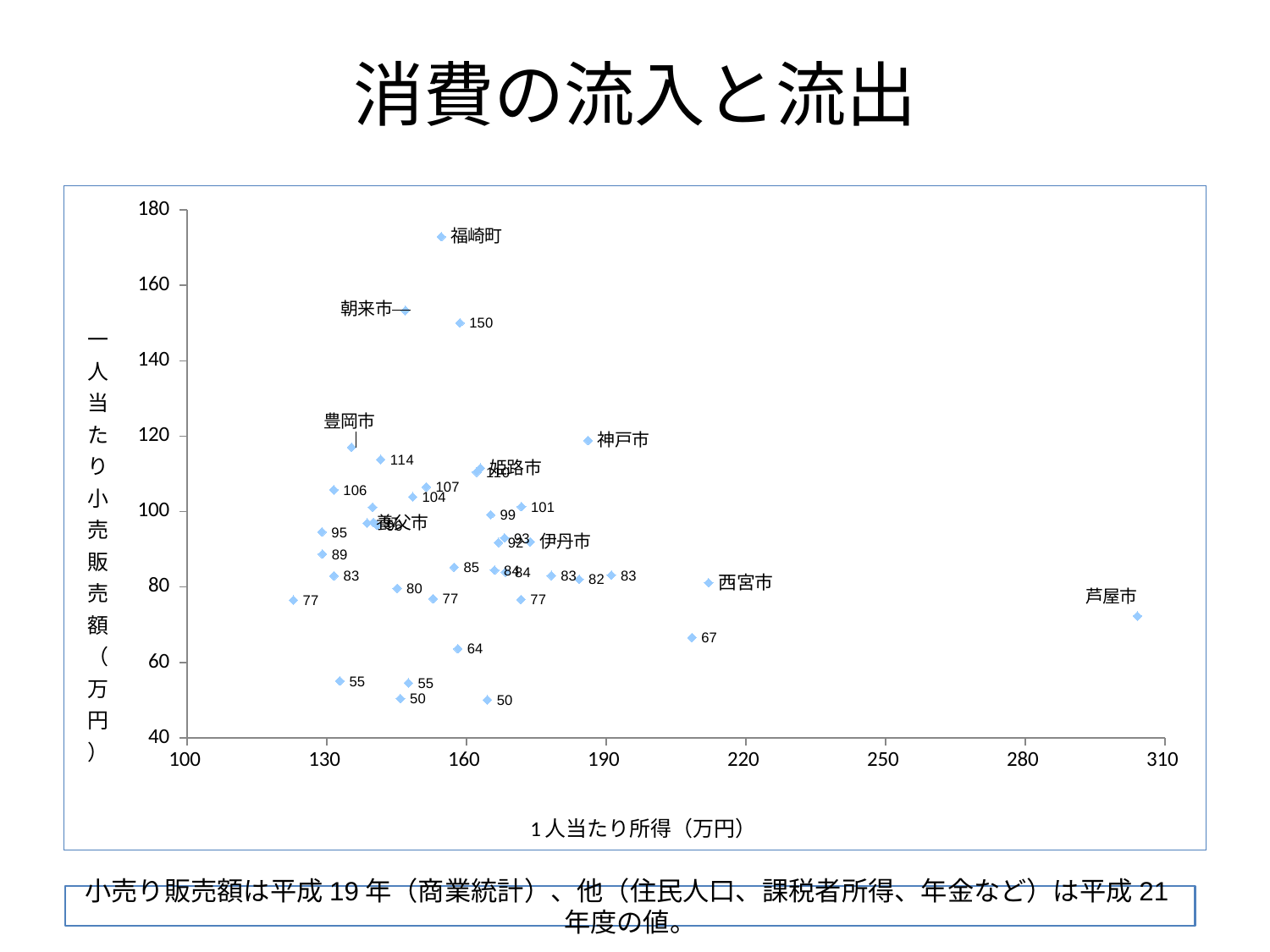
What is the label of the x axis? 1人当たり所得（万円） What kind of chart is shown on the slide? scatter chart What is the largest numeric data label printed next to a point on the chart? 150 Is the per-person retail sales value for 西宮市 greater or less than 100? less Is the per-person retail sales value for 福崎町 greater or less than 160? greater Which labeled municipality has the highest per-person income (x value)? 芦屋市 Which has higher per-person retail sales, 神戸市 or 西宮市? 神戸市 Which has higher per-person retail sales, 福崎町 or 朝来市? 福崎町 Is the per-person retail sales value for 神戸市 greater or less than 100? greater Which labeled municipality has the highest per-person retail sales (y value)? 福崎町 What is the title of the chart? 消費の流入と流出